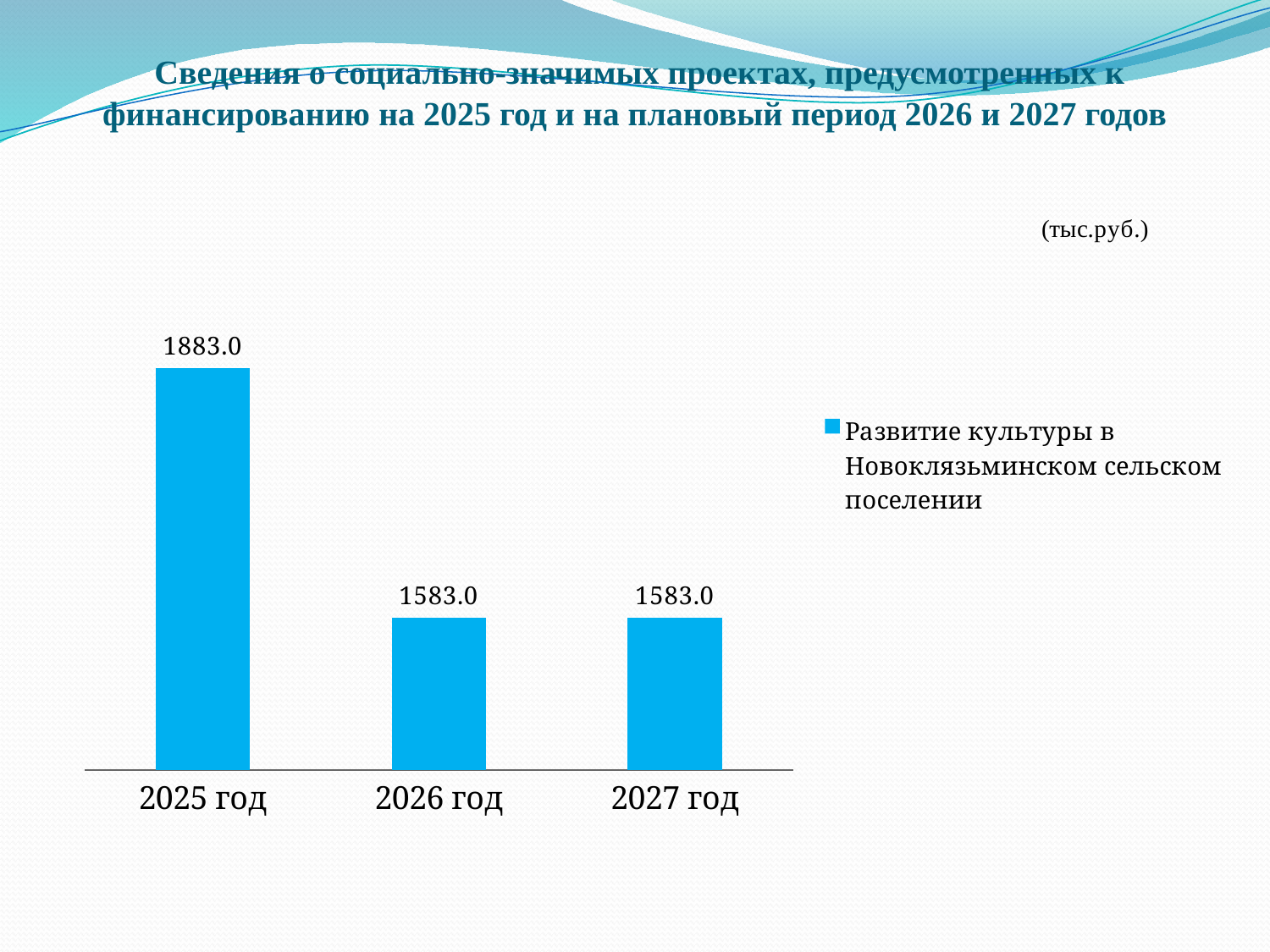
Do the values rise or fall from 2025 год to 2026 год? Fall What is the difference between the values for 2025 год and 2026 год? 300.0 What is the value for 2025 год? 1883.0 How many series does the legend list? 1 What series name is listed in the legend? Развитие культуры в Новоклязьминском сельском поселении Which is larger, the value for 2025 год or the value for 2027 год? 2025 год What unit is indicated for the chart values? тыс.руб. What is the value for 2026 год? 1583.0 Which year has the highest value? 2025 год How many categories are shown on the x axis? 3 What is the value for 2027 год? 1583.0 What kind of chart is shown on the slide? Bar chart